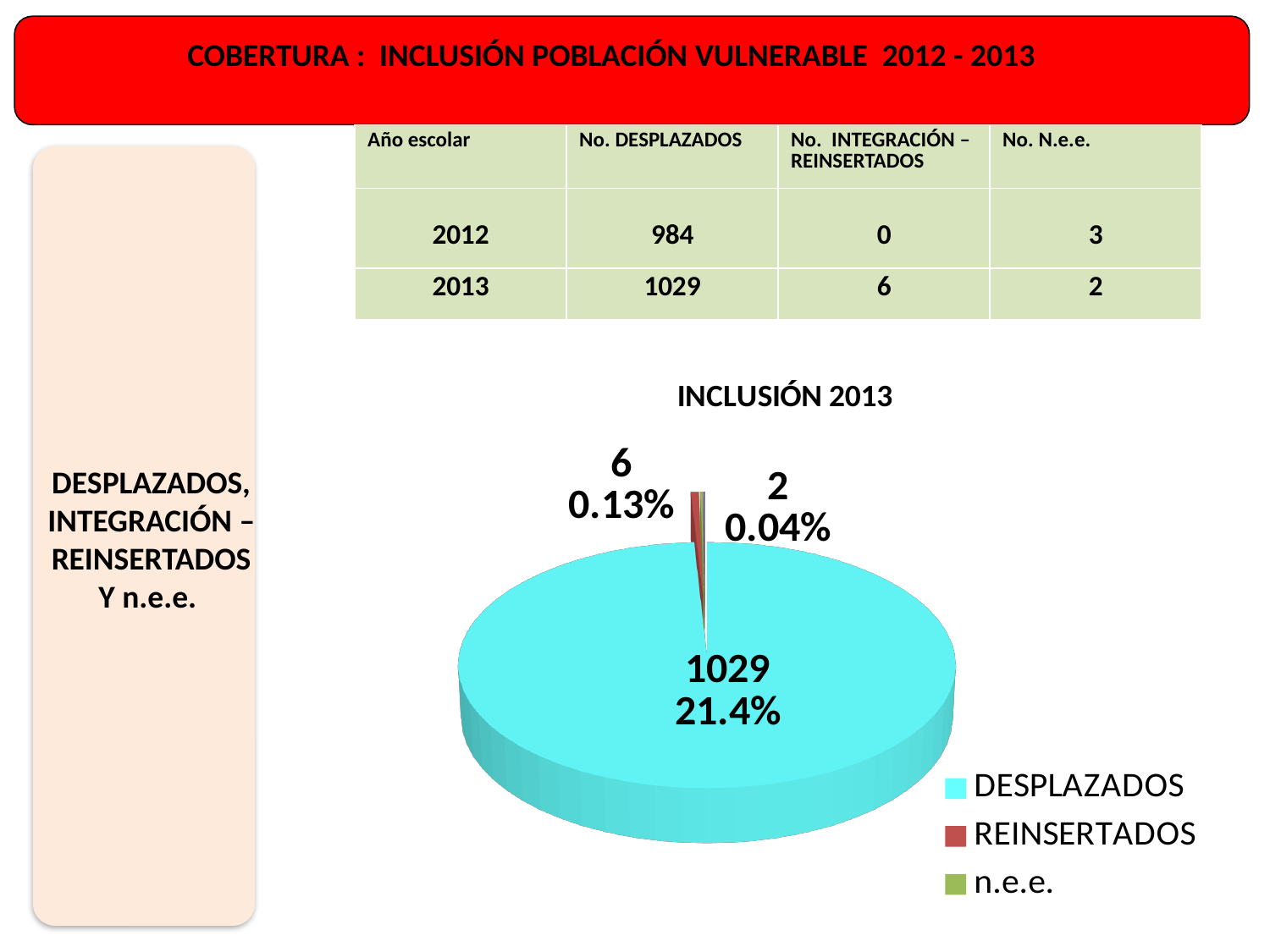
What is the value shown for DESPLAZADOS in the pie chart? 1029 What type of chart is shown on the slide? pie chart What is the value shown for REINSERTADOS in the pie chart? 6 What is the value shown for n.e.e. in the pie chart? 2 Which category has the largest slice in the pie chart? DESPLAZADOS Which category has the smallest slice in the pie chart? n.e.e. What is the difference between the values for DESPLAZADOS and REINSERTADOS in the pie chart? 1023 What percentage label is printed on the DESPLAZADOS slice? 21.4% What percentage label is printed on the REINSERTADOS slice? 0.13% How many categories does the legend of the pie chart list? 3 What is the title of the chart? INCLUSIÓN 2013 What percentage label is printed on the n.e.e. slice? 0.04%